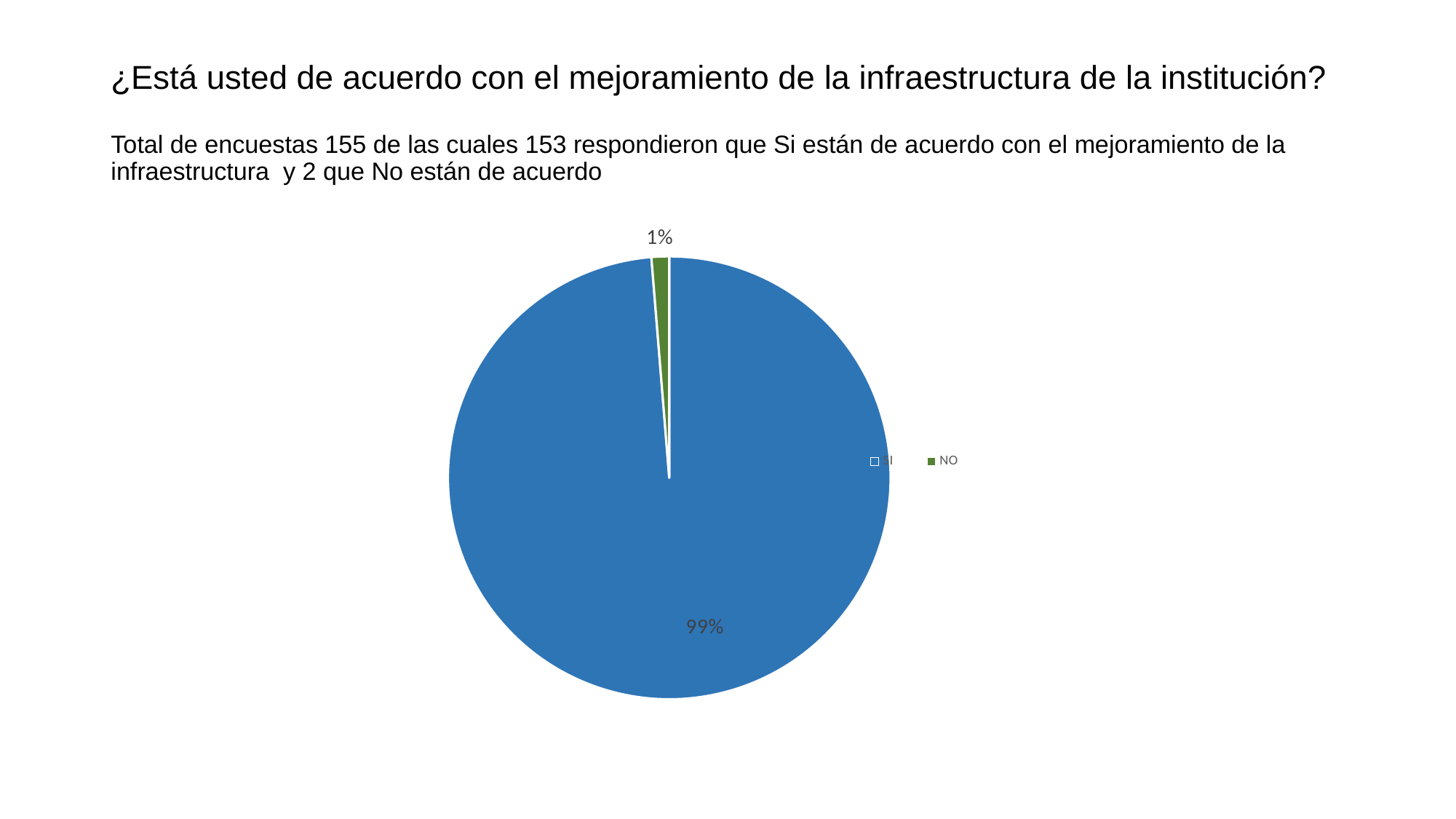
What percentage does the NO slice of the pie chart represent? 1% What is the difference in percentage points between the 99% slice and the 1% slice? 98 What colour is the NO slice in the pie chart? green Which slice of the pie chart is the smallest? NO What kind of chart is shown on the slide? pie chart How many entries does the legend of the pie chart list? 2 What share of the pie does the green slice take? 1% Is the NO slice larger or smaller than the blue slice? smaller How many slices does the pie chart have? 2 What percentage does the large blue slice of the pie chart represent? 99% What colour is the 99% slice in the pie chart? blue